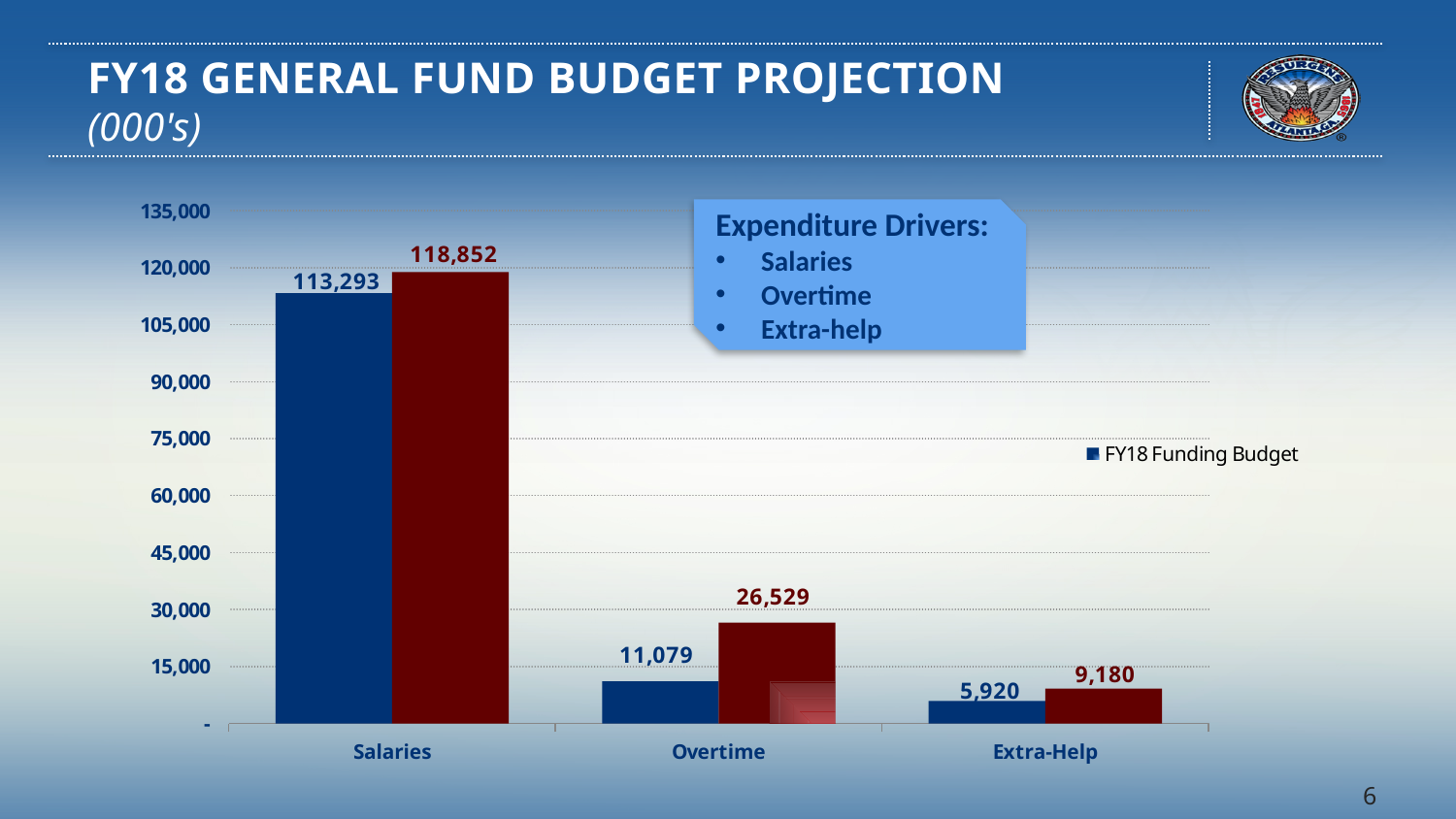
For Salaries, what is the difference between the dark red bar (118,852) and the FY18 Funding Budget bar (113,293)? 5,559 For Overtime, how much larger is the dark red bar value than the FY18 Funding Budget value? 15,450 What is the FY18 Funding Budget value for Extra-Help? 5,920 What type of chart is shown on the slide? Bar chart What value is shown on the dark red bar for Overtime? 26,529 Which category has the highest FY18 Funding Budget value? Salaries How many categories are shown on the x axis of the chart? 3 Which is larger: the dark red bar for Overtime or the dark red bar for Extra-Help? Overtime What is the FY18 Funding Budget value for Salaries? 113,293 Is the FY18 Funding Budget value for Overtime greater or less than 15,000? less How many series does the chart legend list? 1 Which category has the lowest value on its dark red bar? Extra-Help